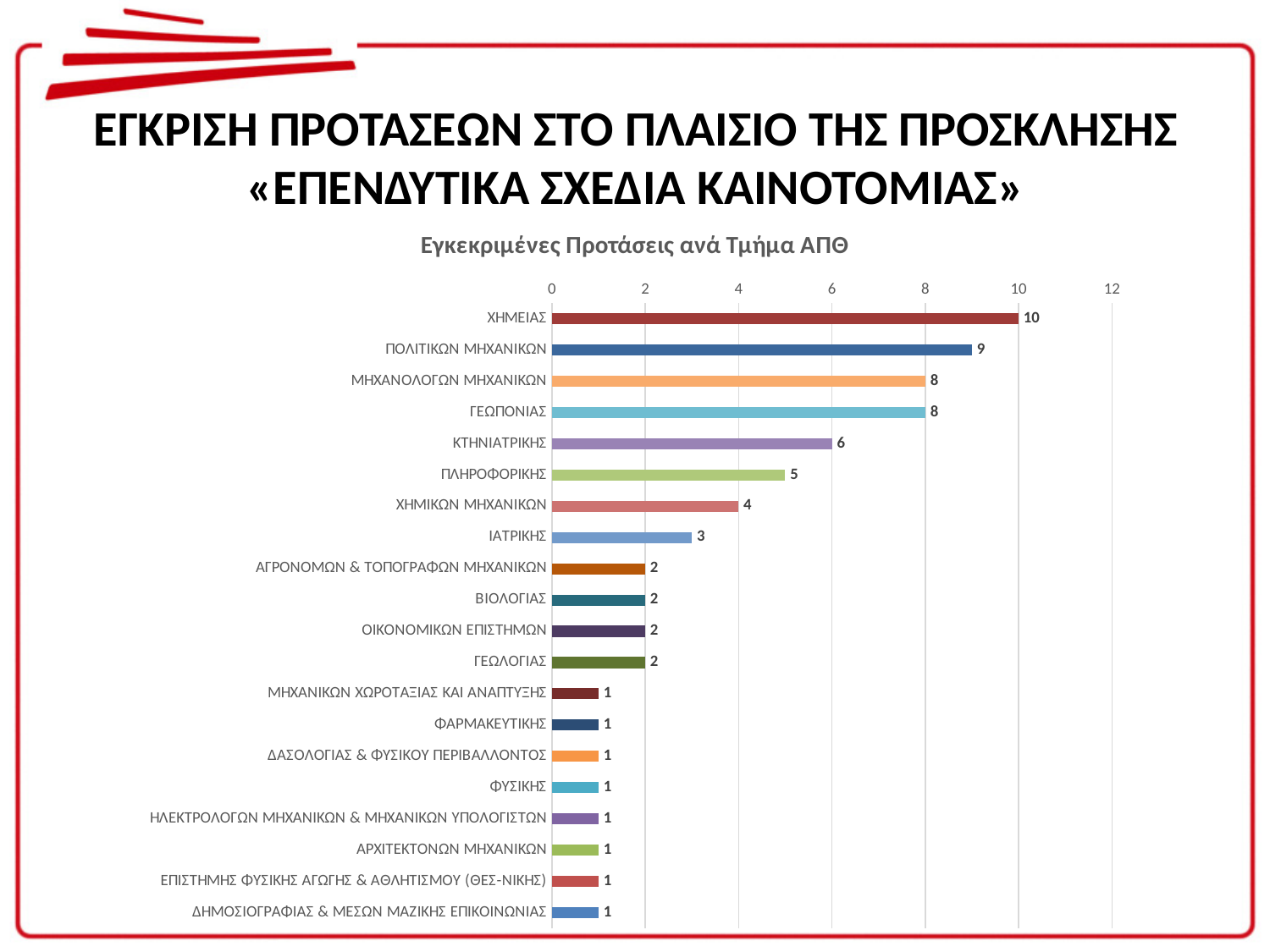
What value is shown for ΙΑΤΡΙΚΗΣ? 3 What is the title of the chart? Εγκεκριμένες Προτάσεις ανά Τμήμα ΑΠΘ What kind of chart is shown on the slide? bar chart Which department has the highest value? ΧΗΜΕΙΑΣ What value is shown for ΠΛΗΡΟΦΟΡΙΚΗΣ? 5 Is the value for ΠΟΛΙΤΙΚΩΝ ΜΗΧΑΝΙΚΩΝ greater or less than 6? greater What value is shown for ΧΗΜΕΙΑΣ? 10 What is the difference between the values for ΧΗΜΕΙΑΣ and ΠΟΛΙΤΙΚΩΝ ΜΗΧΑΝΙΚΩΝ? 1 How many departments are shown in the chart? 20 What is the difference between the values for ΓΕΩΠΟΝΙΑΣ and ΧΗΜΙΚΩΝ ΜΗΧΑΝΙΚΩΝ? 4 Which is larger, the value for ΚΤΗΝΙΑΤΡΙΚΗΣ or the value for ΙΑΤΡΙΚΗΣ? ΚΤΗΝΙΑΤΡΙΚΗΣ What value is shown for ΚΤΗΝΙΑΤΡΙΚΗΣ? 6